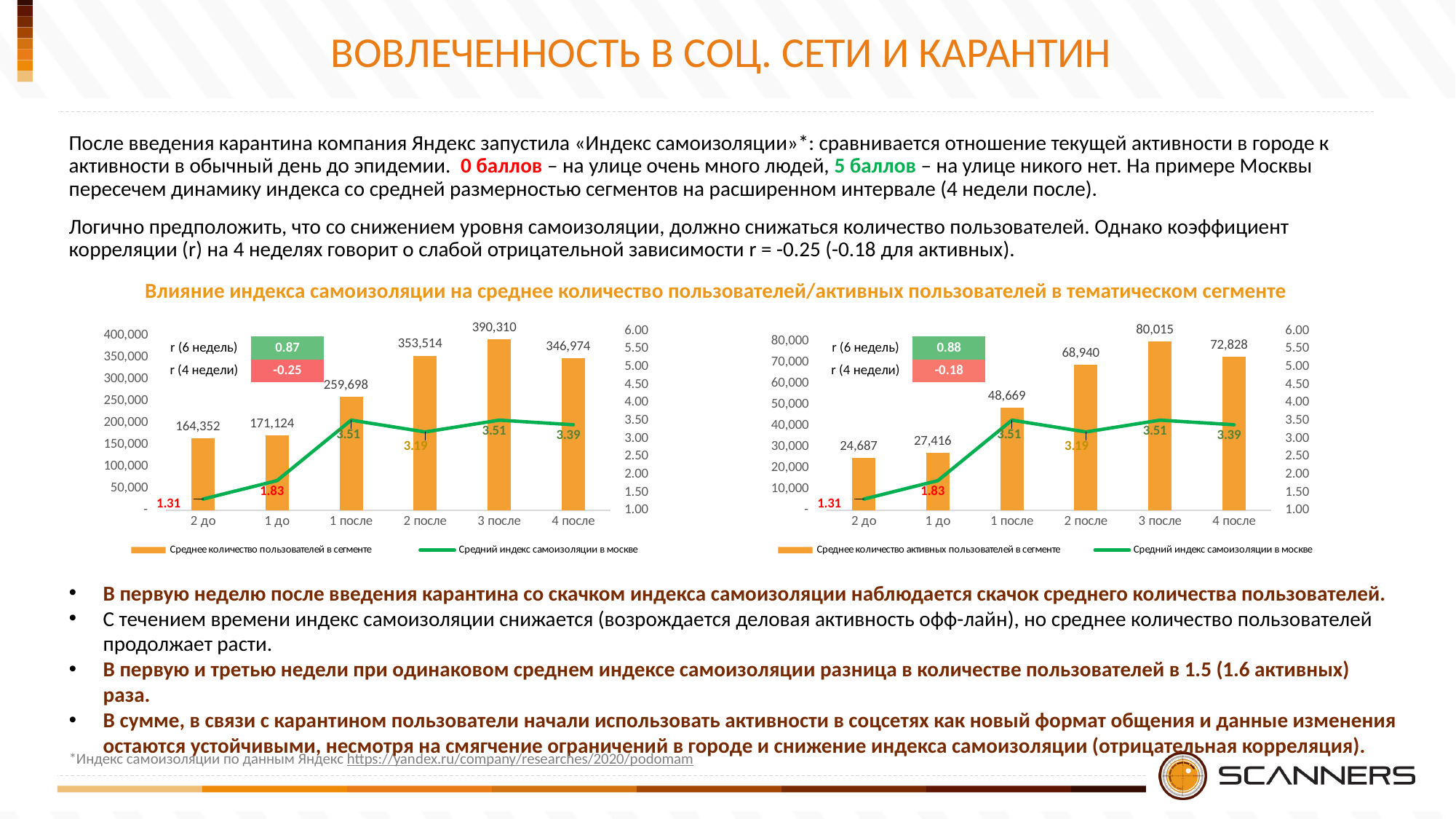
On the left chart, what is the average number of users in the segment for '2 до'? 164,352 On the right chart, what is the average number of active users in the segment for '2 после'? 68,940 On the left chart, which category has the lowest average number of users? 2 до On the left chart, what is the average self-isolation index in Moscow for '1 до'? 1.83 How many series does the legend of the right chart list? 2 On the left chart, what is the correlation coefficient r for 4 weeks? -0.25 How many categories are shown on the x axis of the left chart? 6 On the left chart, is the average number of users for '2 после' greater or less than '4 после'? greater On the right chart, what is the difference in average active users between '3 после' and '4 после'? 7,187 On the right chart, is the average number of active users for '1 после' greater or less than 40,000? greater On the left chart, what is the average number of users in the segment for '3 после'? 390,310 On the right chart, which category has the highest average number of active users? 3 после